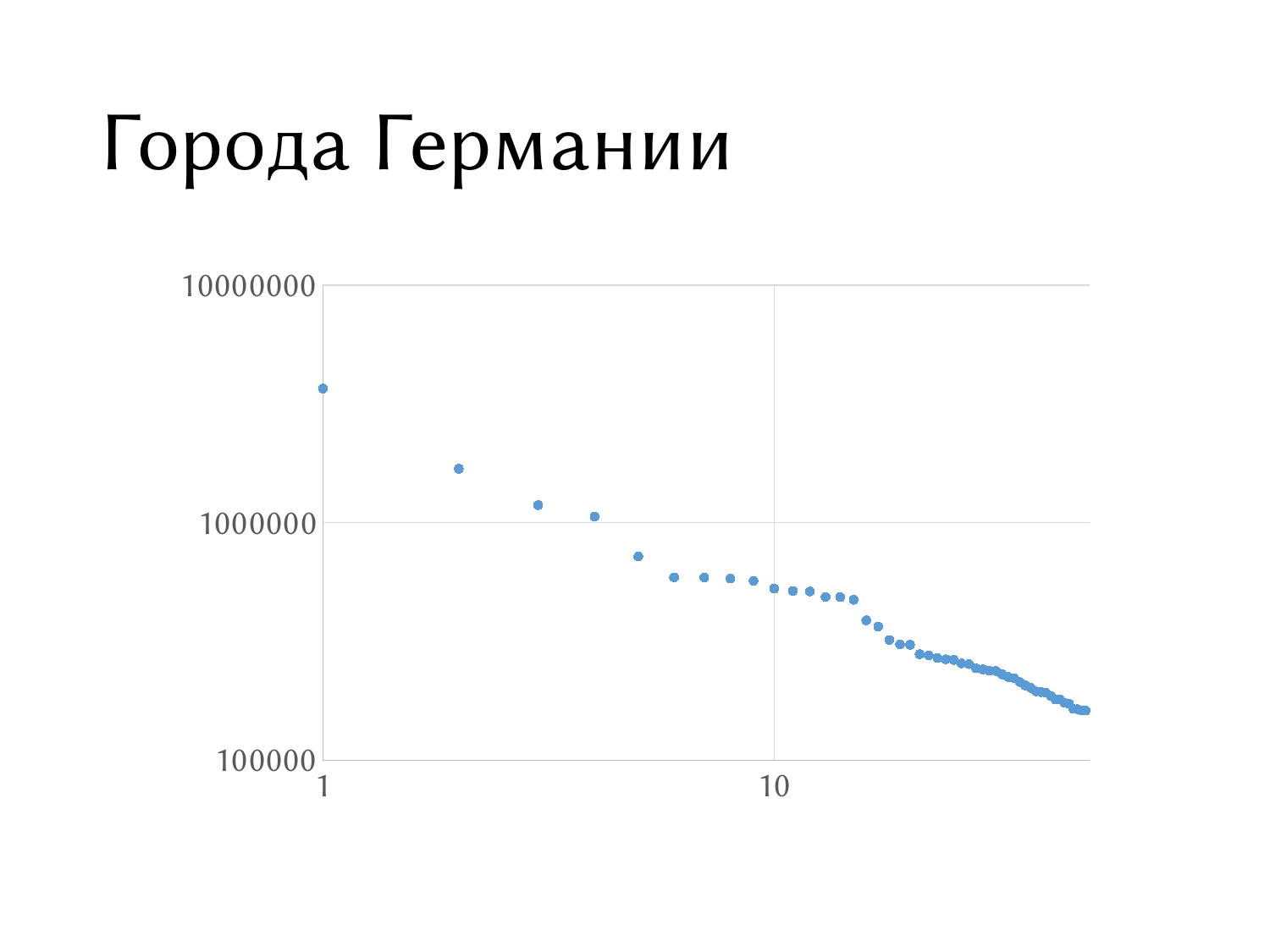
What is the title of the chart? Города Германии At which x value is the highest point plotted? 1 What is the highest tick label shown on the y axis? 10000000 Do the plotted values rise or fall as x increases? fall What kind of chart is shown on the slide? scatter plot Is the value of the point at x = 1 greater or less than 10000000? less Is the value of the point at x = 10 greater or less than 100000? greater Is the value of the point at x = 10 greater or less than 1000000? less Which point has the larger value, the one at x = 1 or the one at x = 10? x = 1